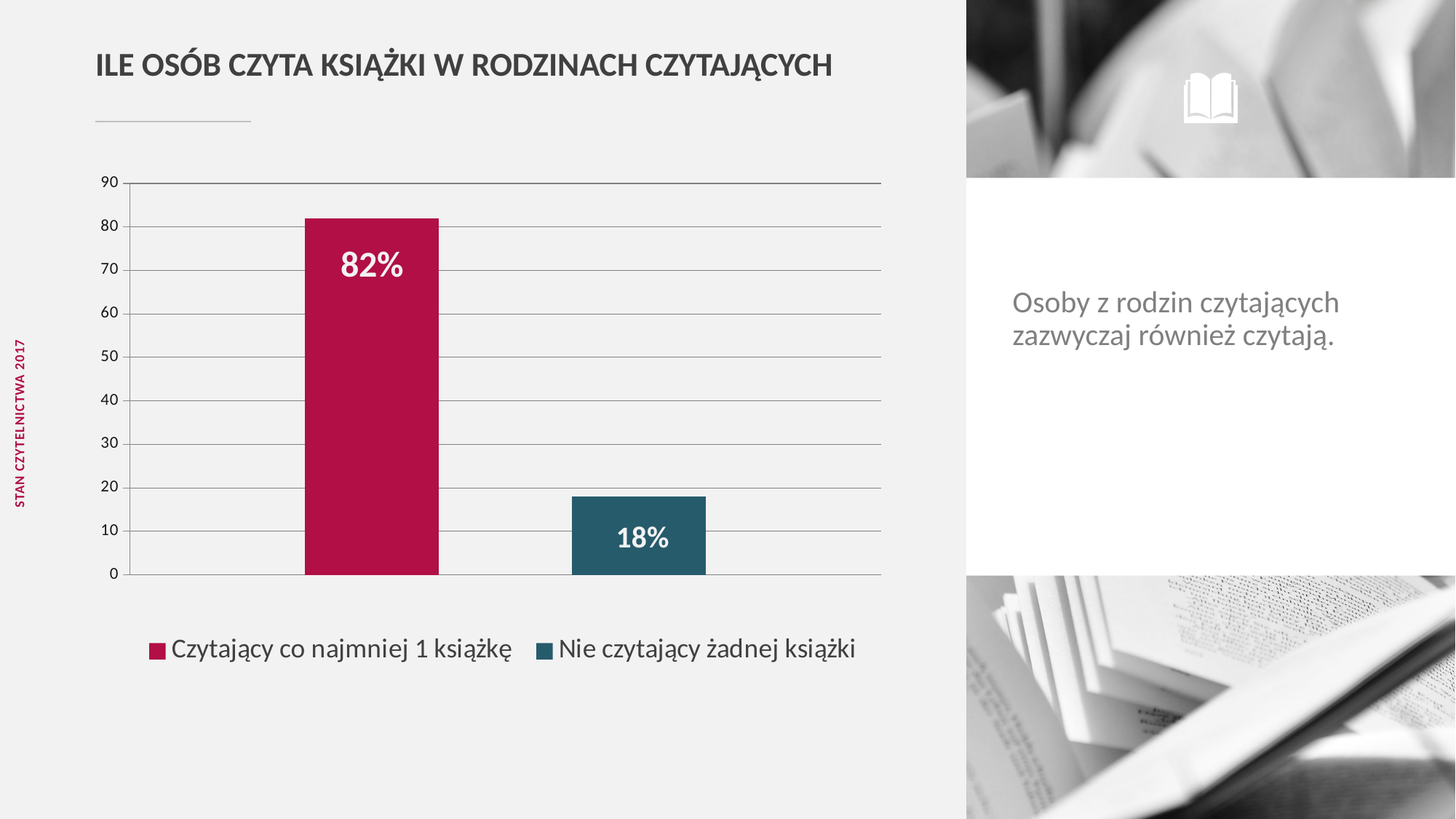
What is the difference between the values for "Czytający co najmniej 1 książkę" and "Nie czytający żadnej książki"? 64% What is the title of the chart on the slide? ILE OSÓB CZYTA KSIĄŻKI W RODZINACH CZYTAJĄCYCH Is the value for "Nie czytający żadnej książki" greater or less than 20? less How many series does the legend list? 2 What is the value for "Nie czytający żadnej książki"? 18% What kind of chart is shown on the slide? bar chart What colour is the bar for "Nie czytający żadnej książki"? dark teal What is the value for "Czytający co najmniej 1 książkę"? 82% Which is larger: the value for "Czytający co najmniej 1 książkę" or for "Nie czytający żadnej książki"? Czytający co najmniej 1 książkę Which series has the highest value? Czytający co najmniej 1 książkę Which series has the lowest value? Nie czytający żadnej książki Is the value for "Czytający co najmniej 1 książkę" greater or less than 80? greater